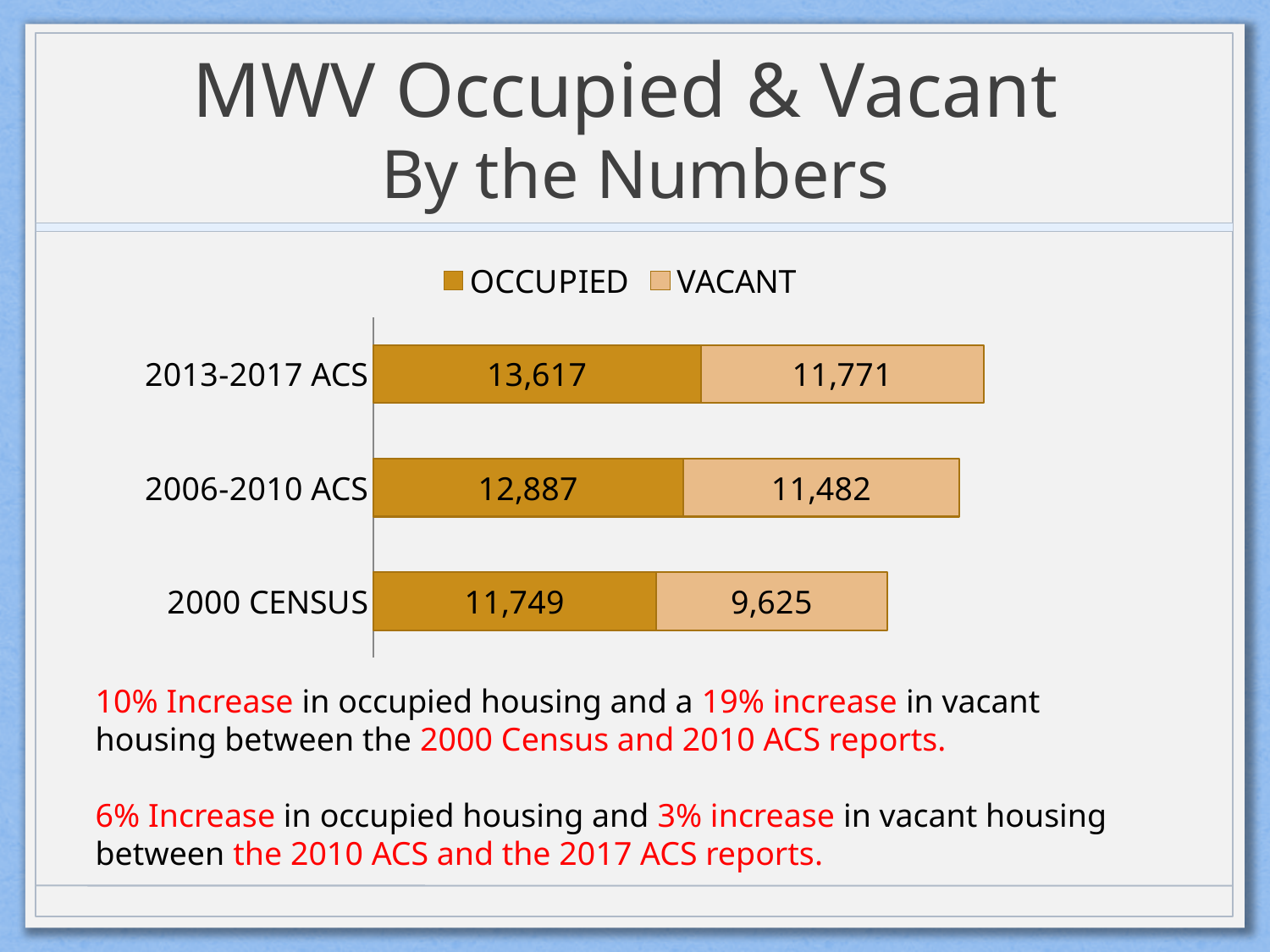
What is the VACANT value for 2006-2010 ACS? 11,482 Which category has the lowest VACANT value? 2000 CENSUS How many categories are shown on the chart? 3 Which is larger, the OCCUPIED value for 2006-2010 ACS or the VACANT value for 2013-2017 ACS? OCCUPIED value for 2006-2010 ACS What is the total of the stacked bar for 2000 CENSUS? 21,374 What is the OCCUPIED value for 2013-2017 ACS? 13,617 What is the total of the stacked bar for 2013-2017 ACS? 25,388 Which category has the highest OCCUPIED value? 2013-2017 ACS What is the VACANT value for 2000 CENSUS? 9,625 What kind of chart is shown on the slide? Stacked bar chart How many series does the legend list? 2 What is the difference between the OCCUPIED values for 2013-2017 ACS and 2000 CENSUS? 1,868